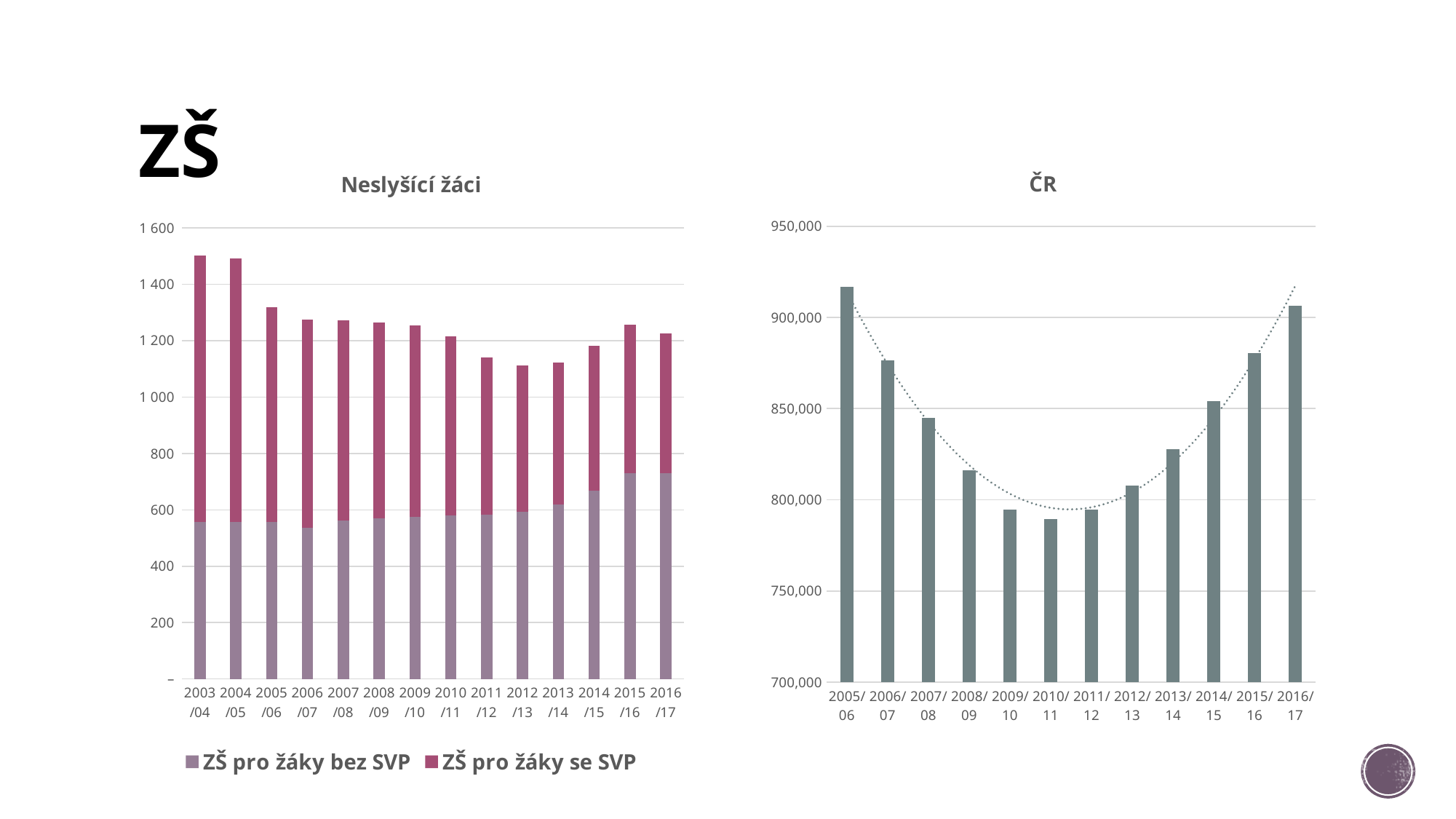
What kind of chart is the "Neslyšící žáci" chart? Stacked bar chart In the "Neslyšící žáci" chart, which series is shown in the darker magenta colour? ZŠ pro žáky se SVP In the "Neslyšící žáci" chart, which school year has the highest total bar? 2003/04 In the "Neslyšící žáci" chart, is the total for 2003/04 greater or less than 1 400? greater How many school years are shown on the x axis of the "ČR" chart? 12 In the "Neslyšící žáci" chart, which school year has the lowest total bar? 2012/13 In the "ČR" chart, which school year has the highest value? 2005/06 In the "ČR" chart, is the value for 2010/11 greater or less than 800,000? less In the "ČR" chart, which school year has the lowest value? 2010/11 How many school years are shown on the x axis of the "Neslyšící žáci" chart? 14 How many series does the legend of the "Neslyšící žáci" chart list? 2 In the "Neslyšící žáci" chart, is the total for 2012/13 greater or less than 1 200? less